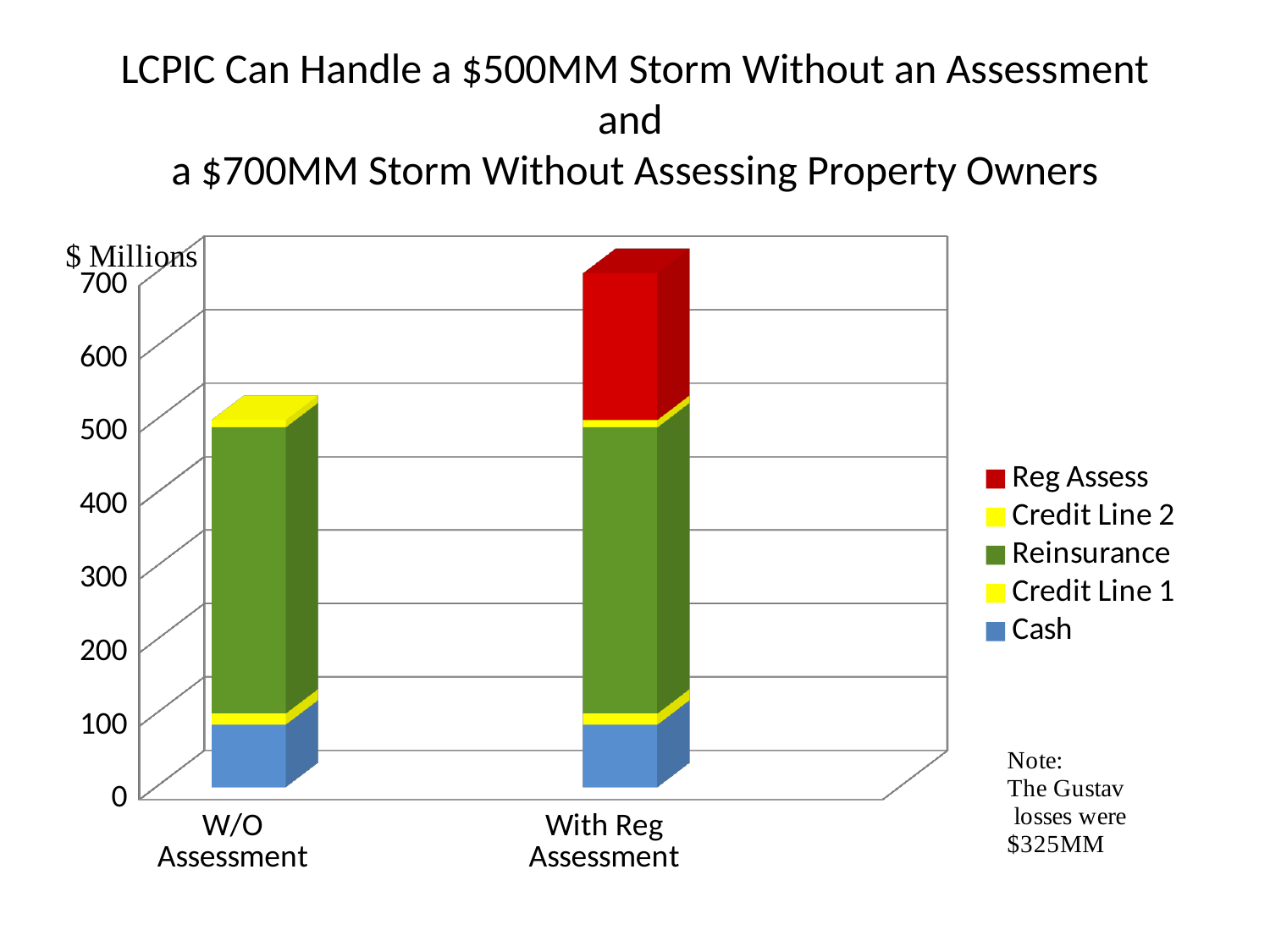
Is the total of the W/O Assessment bar greater or less than 600? less Which category has the tallest stacked bar? With Reg Assessment Is the total of the With Reg Assessment bar greater or less than 600? greater How many series does the chart's legend list? 5 What unit label is shown at the top of the chart's vertical axis? $ Millions Which category has the shortest stacked bar? W/O Assessment What kind of chart is shown on the slide? stacked bar chart Is the total of the W/O Assessment bar greater or less than 400? greater Which stacked bar is taller, W/O Assessment or With Reg Assessment? With Reg Assessment How many categories are shown on the x axis of the chart? 2 Which series is shown in red in the chart's legend? Reg Assess